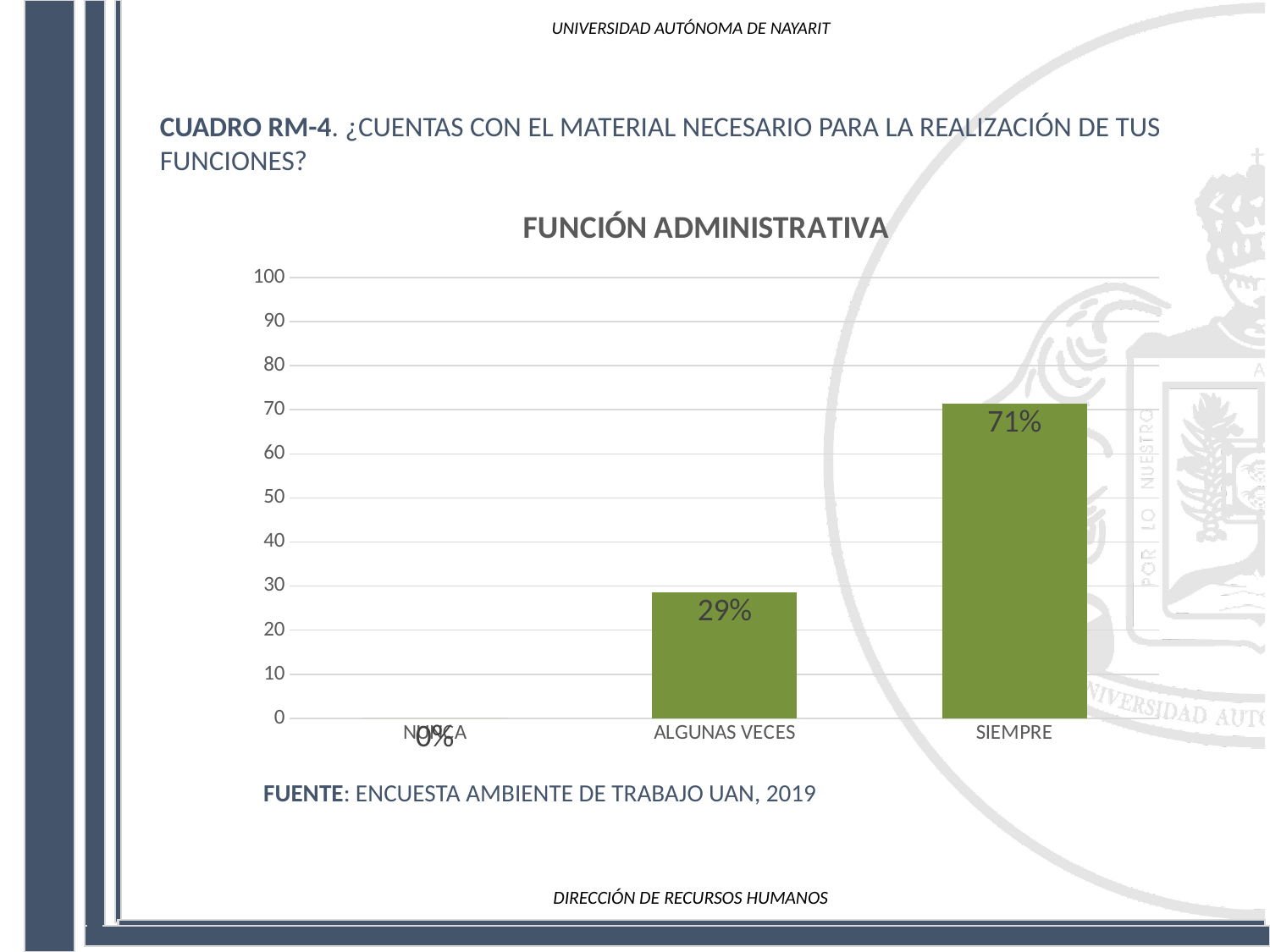
What is the value for SIEMPRE? 71% Which is larger, the value for ALGUNAS VECES or the value for SIEMPRE? SIEMPRE How many categories are shown on the x axis? 3 Which category has the lowest value? NUNCA What is the value for NUNCA? 0% What is the difference between the values for SIEMPRE and ALGUNAS VECES? 42% What is the value for ALGUNAS VECES? 29% What kind of chart is shown on the slide? Bar chart What is the title of the chart? FUNCIÓN ADMINISTRATIVA Which category has the highest value? SIEMPRE Is the value for ALGUNAS VECES greater or less than 40? less Is the value for SIEMPRE greater or less than 60? greater